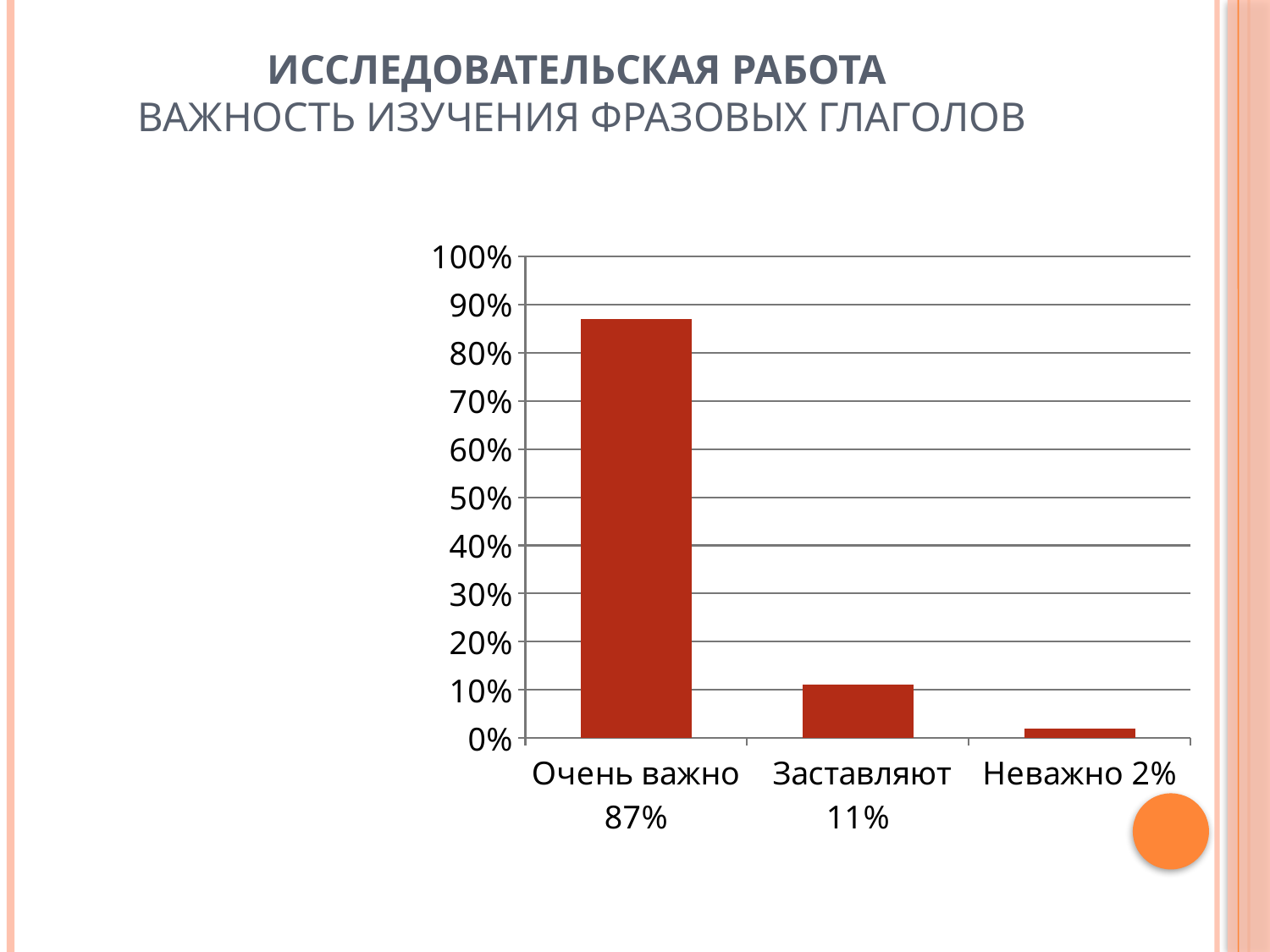
Which is larger, the value for "Заставляют" or the value for "Неважно"? Заставляют How many bars (categories) does the chart show? 3 Which category has the highest value? Очень важно What kind of chart is shown on the slide? bar chart What is the value for the category "Неважно"? 2% What is the difference between the values for "Заставляют" and "Неважно"? 9% Is the value for "Очень важно" greater or less than 80%? greater Do the bar values rise or fall from left to right along the x axis? fall What is the value for the category "Очень важно"? 87% What is the difference between the values for "Очень важно" and "Заставляют"? 76% Which category has the lowest value? Неважно What is the value for the category "Заставляют"? 11%